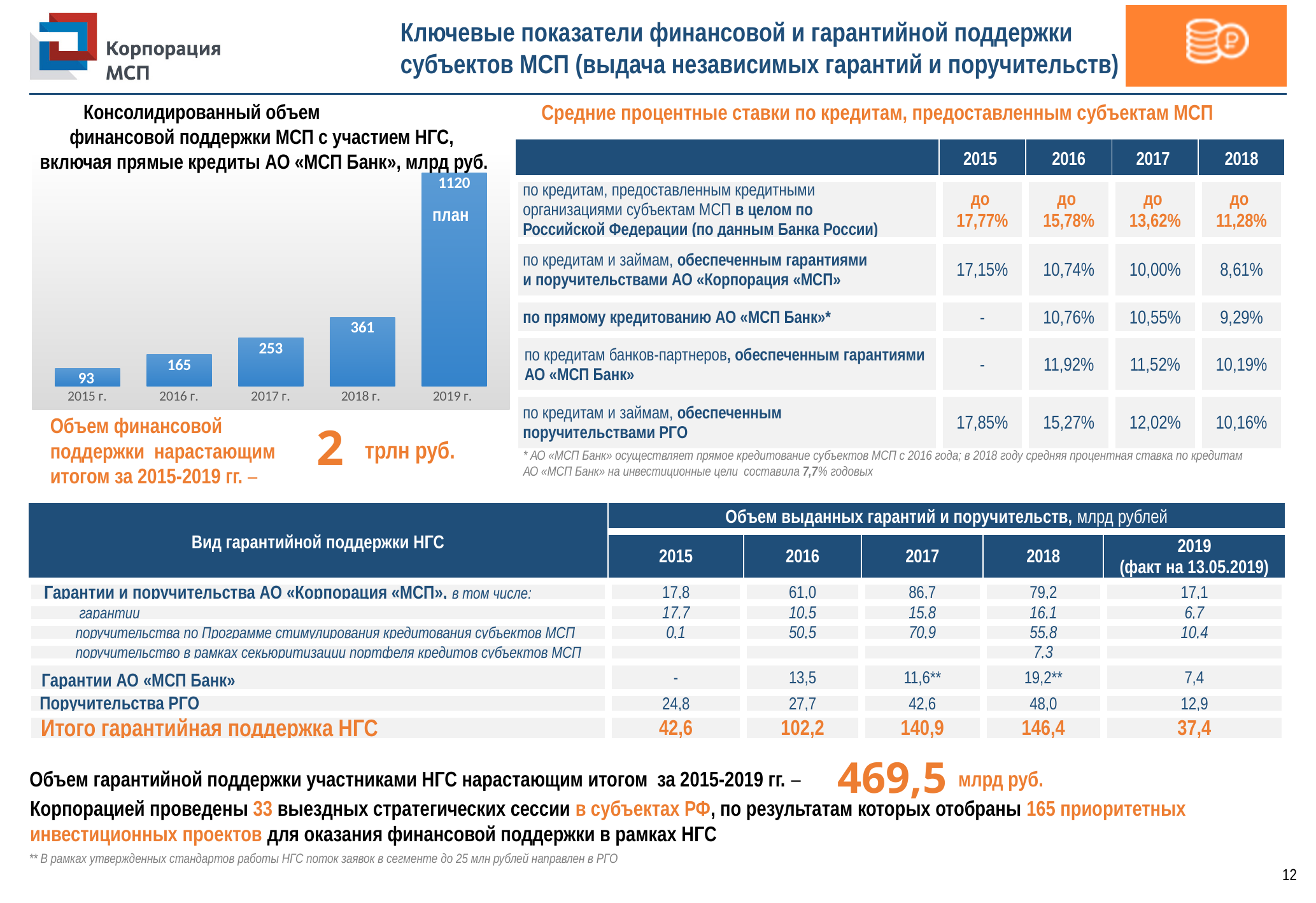
In the bar chart on the left, what is the value for 2018 г.? 361 In the bar chart on the left, what is the planned value for 2019 г.? 1120 How many bars (years) are shown in the bar chart on the left? 5 In the bar chart on the left, what is the difference between the values for 2016 г. and 2015 г.? 72 In the bar chart on the left, what is the value for 2015 г.? 93 What type of chart is shown on the left side of the slide under the title «Консолидированный объем финансовой поддержки МСП с участием НГС»? Bar chart In the bar chart on the left, which year has the highest value? 2019 г. In the bar chart on the left, what is the difference between the values for 2018 г. and 2017 г.? 108 In the bar chart on the left, which is larger: the value for 2016 г. or the value for 2017 г.? 2017 г. In the bar chart on the left, do the values rise or fall from 2015 г. to 2019 г.? Rise In the bar chart on the left, which year has the lowest value? 2015 г. In the bar chart on the left, what is the value for 2017 г.? 253